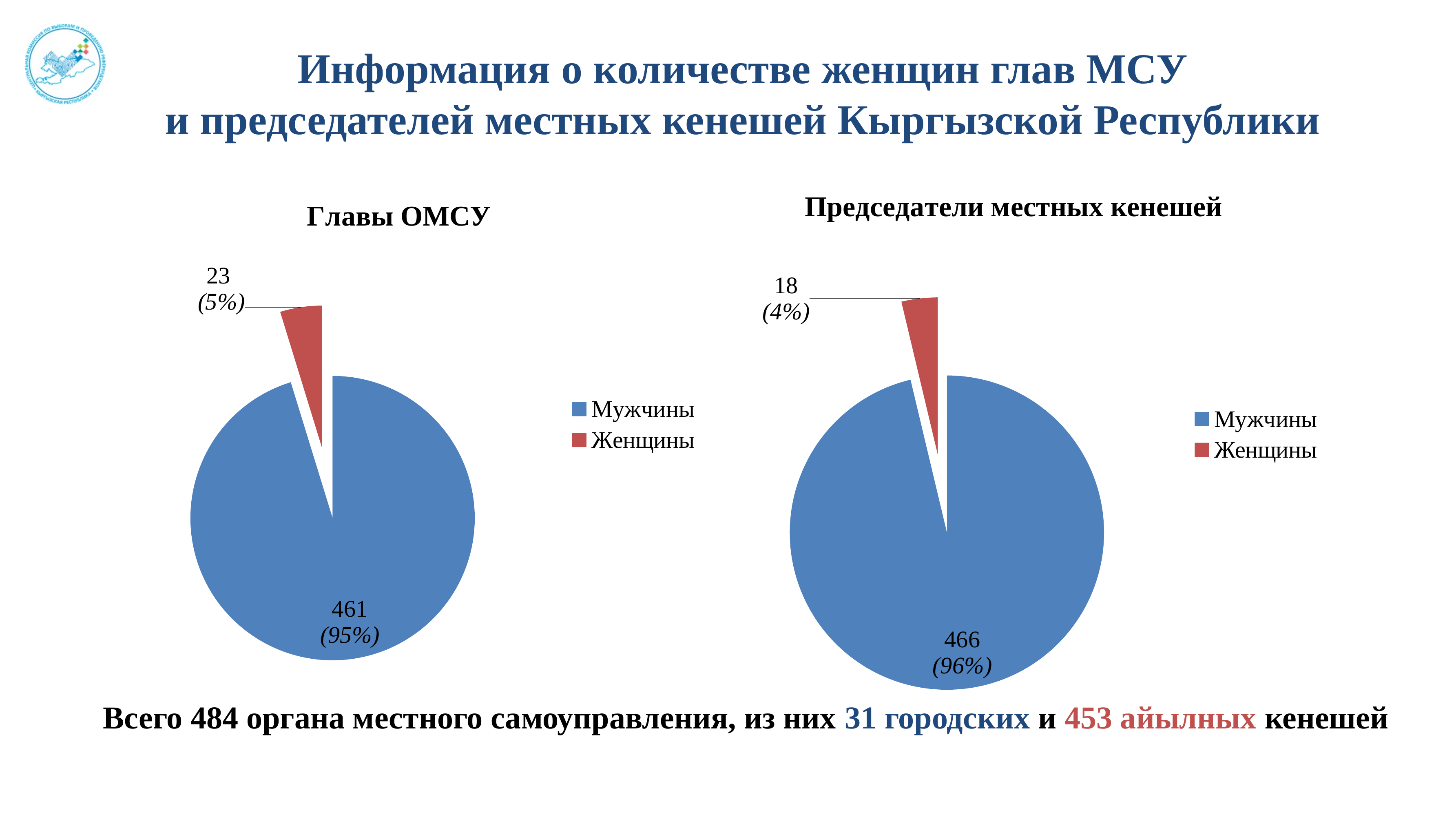
In the "Председатели местных кенешей" chart, what is the value for Мужчины? 466 In the "Главы ОМСУ" chart, what share of the pie does Женщины take? 5% In the "Главы ОМСУ" chart, which category is the largest? Мужчины How many entries does the legend of the "Председатели местных кенешей" chart list? 2 In the "Главы ОМСУ" chart, what is the value for Женщины? 23 What kind of chart is the "Главы ОМСУ" chart? Pie chart Which is larger: the value for Женщины in the "Главы ОМСУ" chart or the value for Женщины in the "Председатели местных кенешей" chart? Главы ОМСУ In the "Председатели местных кенешей" chart, which category is the smallest? Женщины In the "Главы ОМСУ" chart, what is the value for Мужчины? 461 In the "Председатели местных кенешей" chart, what is the value for Женщины? 18 In the "Главы ОМСУ" chart, what is the difference between the values for Мужчины and Женщины? 438 In the "Председатели местных кенешей" chart, what share of the pie does Мужчины take? 96%